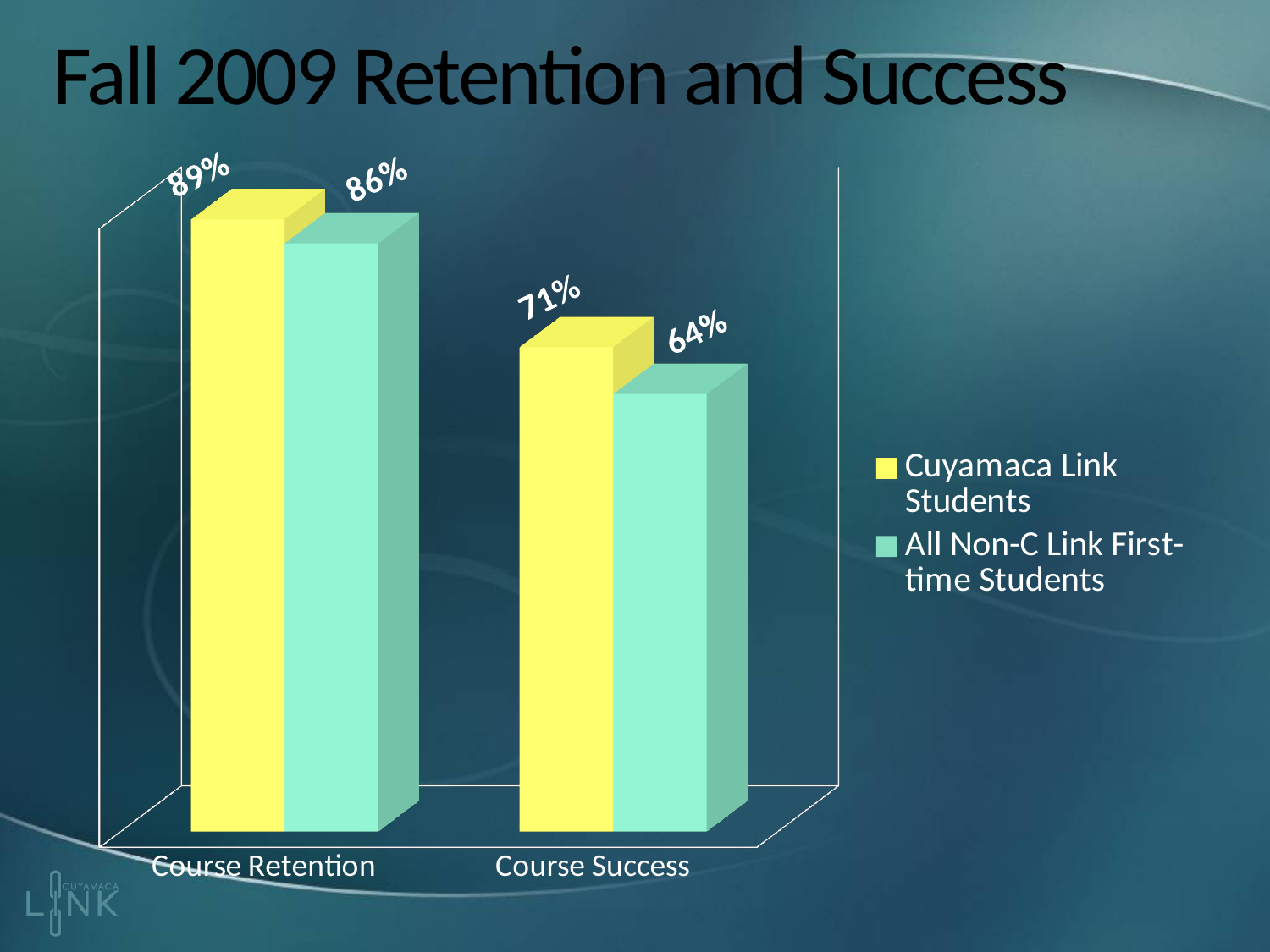
What is the Course Success value for Cuyamaca Link Students? 71% What is the Course Retention value for All Non-C Link First-time Students? 86% How many series does the legend list? 2 What kind of chart is shown on the slide? Bar chart Which series has the larger Course Success value, Cuyamaca Link Students or All Non-C Link First-time Students? Cuyamaca Link Students What is the Course Retention value for Cuyamaca Link Students? 89% What is the difference between the Course Success values for Cuyamaca Link Students and All Non-C Link First-time Students? 7% What is the Course Success value for All Non-C Link First-time Students? 64% Which category has the lowest value for All Non-C Link First-time Students? Course Success What is the difference between the Course Retention values for Cuyamaca Link Students and All Non-C Link First-time Students? 3% Which category has the highest value for Cuyamaca Link Students? Course Retention How many categories are shown on the x axis? 2